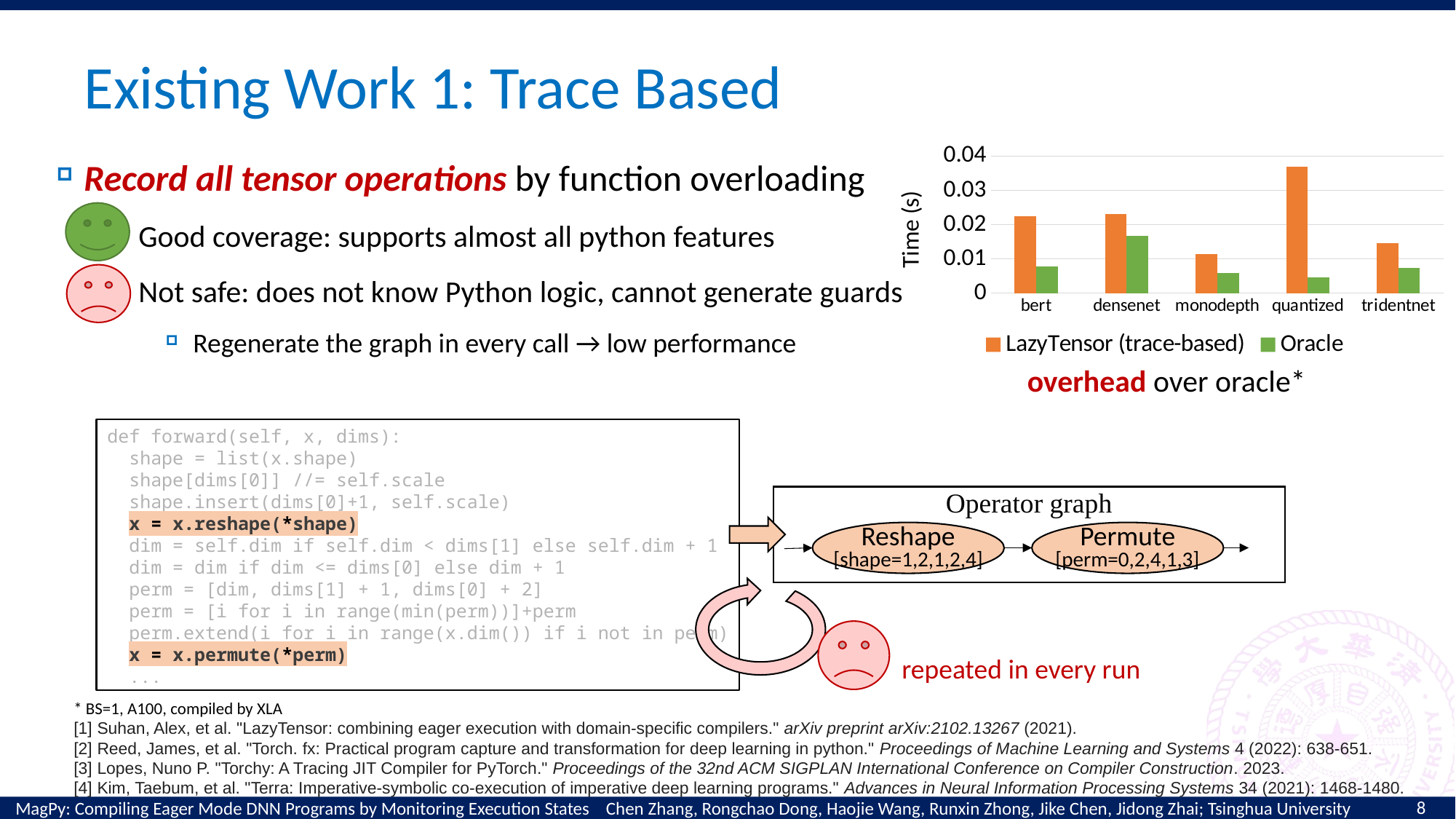
How many series does the chart's legend list? 2 Is the LazyTensor (trace-based) value for quantized greater or less than 0.03? greater How many model categories are shown on the x axis of the chart? 5 Is the Oracle value for bert greater or less than 0.01? less What is the label of the chart's y axis? Time (s) Which category has the highest Oracle time? densenet What kind of chart is shown on the slide? bar chart For bert, which is larger: the LazyTensor (trace-based) time or the Oracle time? LazyTensor (trace-based) Which category has the highest LazyTensor (trace-based) time? quantized Is the Oracle value for densenet greater or less than 0.01? greater Which category has the lowest LazyTensor (trace-based) time? monodepth